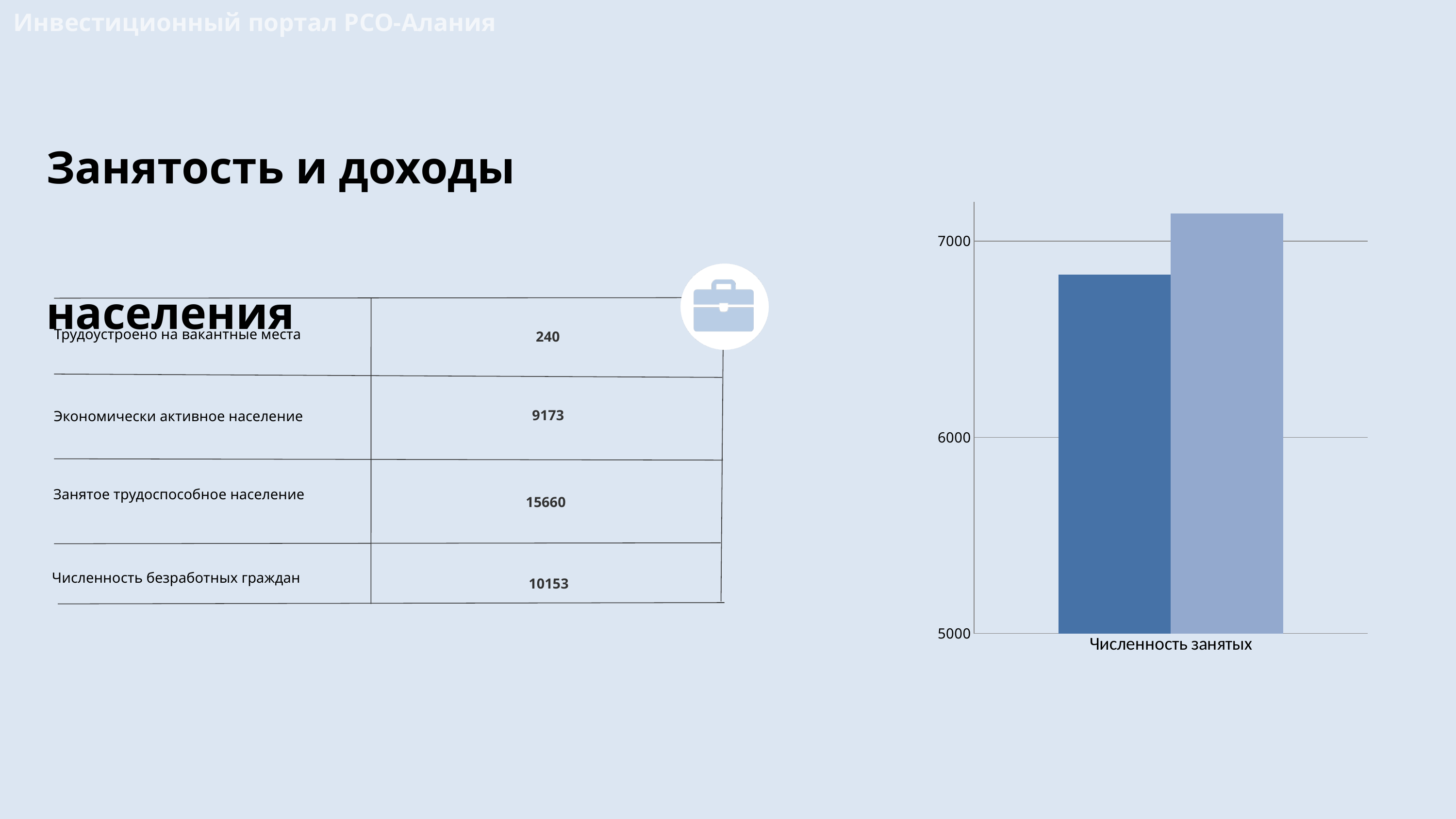
What is the lowest value shown on the y axis of the bar chart? 5000 What kind of chart is shown on the right side of the slide? bar chart In the bar chart, is the dark blue (left) bar greater or less than 6000? greater In the bar chart, is the dark blue (left) bar greater or less than 7000? less In the bar chart, which bar is taller: the dark blue (left) bar or the light blue (right) bar? the light blue (right) bar How many bars are plotted in the bar chart? 2 In the bar chart, is the light blue (right) bar greater or less than 7000? greater How many categories are shown on the x axis of the bar chart? 1 What is the category label on the x axis of the bar chart? Численность занятых